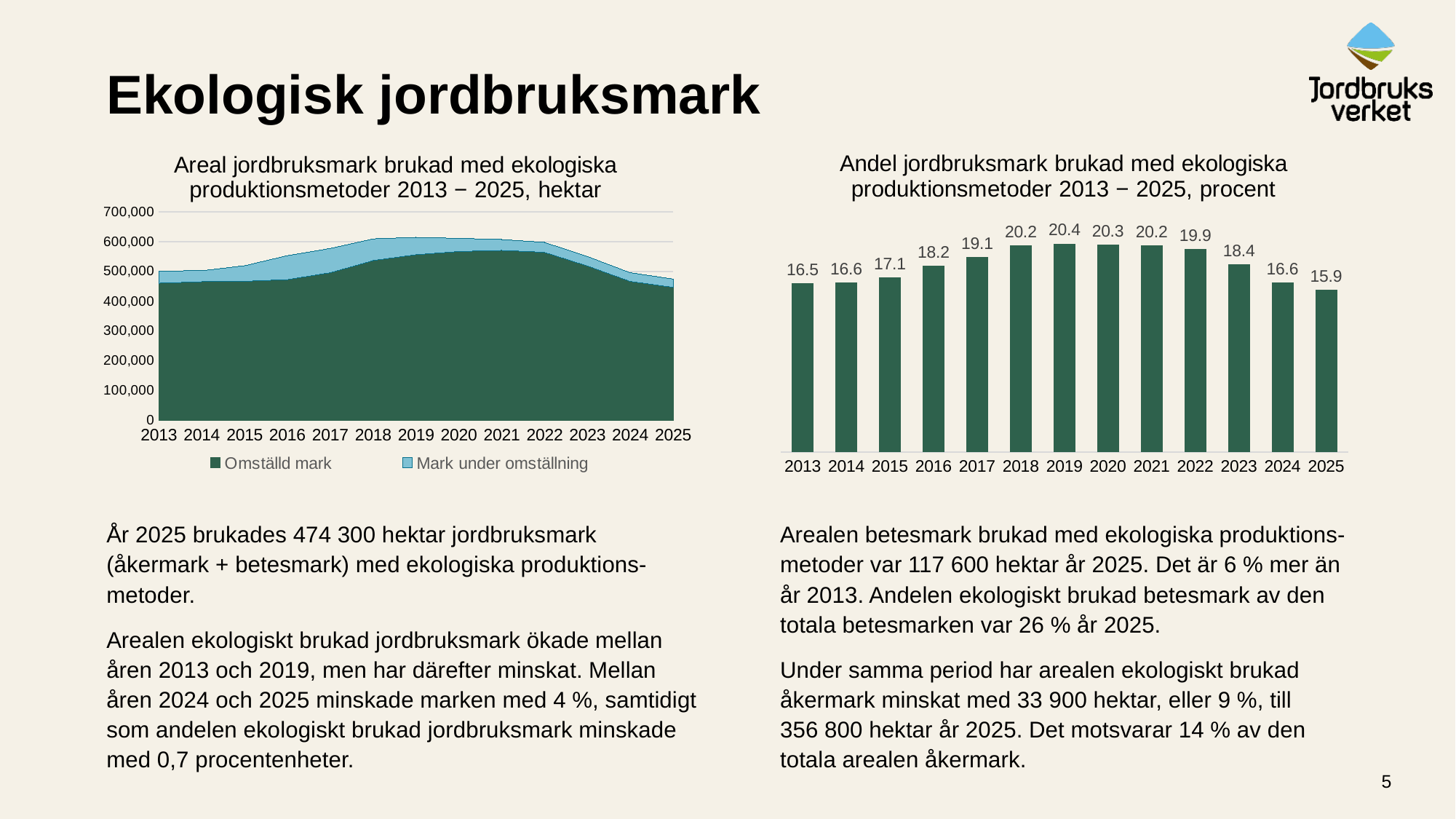
In the chart 'Areal jordbruksmark brukad med ekologiska produktionsmetoder 2013 − 2025, hektar', does the total area rise or fall from 2022 to 2025? Fall In the chart 'Areal jordbruksmark brukad med ekologiska produktionsmetoder 2013 − 2025, hektar', is the total value for 2018 greater or less than 500,000? greater In the chart 'Andel jordbruksmark brukad med ekologiska produktionsmetoder 2013 − 2025, procent', what is the value for 2019? 20.4 In the chart 'Andel jordbruksmark brukad med ekologiska produktionsmetoder 2013 − 2025, procent', which year has the lowest value? 2025 In the chart 'Areal jordbruksmark brukad med ekologiska produktionsmetoder 2013 − 2025, hektar', which series is shown in light blue? Mark under omställning In the chart 'Andel jordbruksmark brukad med ekologiska produktionsmetoder 2013 − 2025, procent', which is larger, the value for 2016 or the value for 2023? 2023 How many series does the legend list in the chart 'Areal jordbruksmark brukad med ekologiska produktionsmetoder 2013 − 2025, hektar'? 2 In the chart 'Andel jordbruksmark brukad med ekologiska produktionsmetoder 2013 − 2025, procent', which year has the highest value? 2019 How many years are shown in the chart 'Andel jordbruksmark brukad med ekologiska produktionsmetoder 2013 − 2025, procent'? 13 In the chart 'Andel jordbruksmark brukad med ekologiska produktionsmetoder 2013 − 2025, procent', what is the difference between the values for 2019 and 2025? 4.5 What kind of chart is the chart on the right, 'Andel jordbruksmark brukad med ekologiska produktionsmetoder 2013 − 2025, procent'? Bar chart In the chart 'Andel jordbruksmark brukad med ekologiska produktionsmetoder 2013 − 2025, procent', what is the value for 2025? 15.9